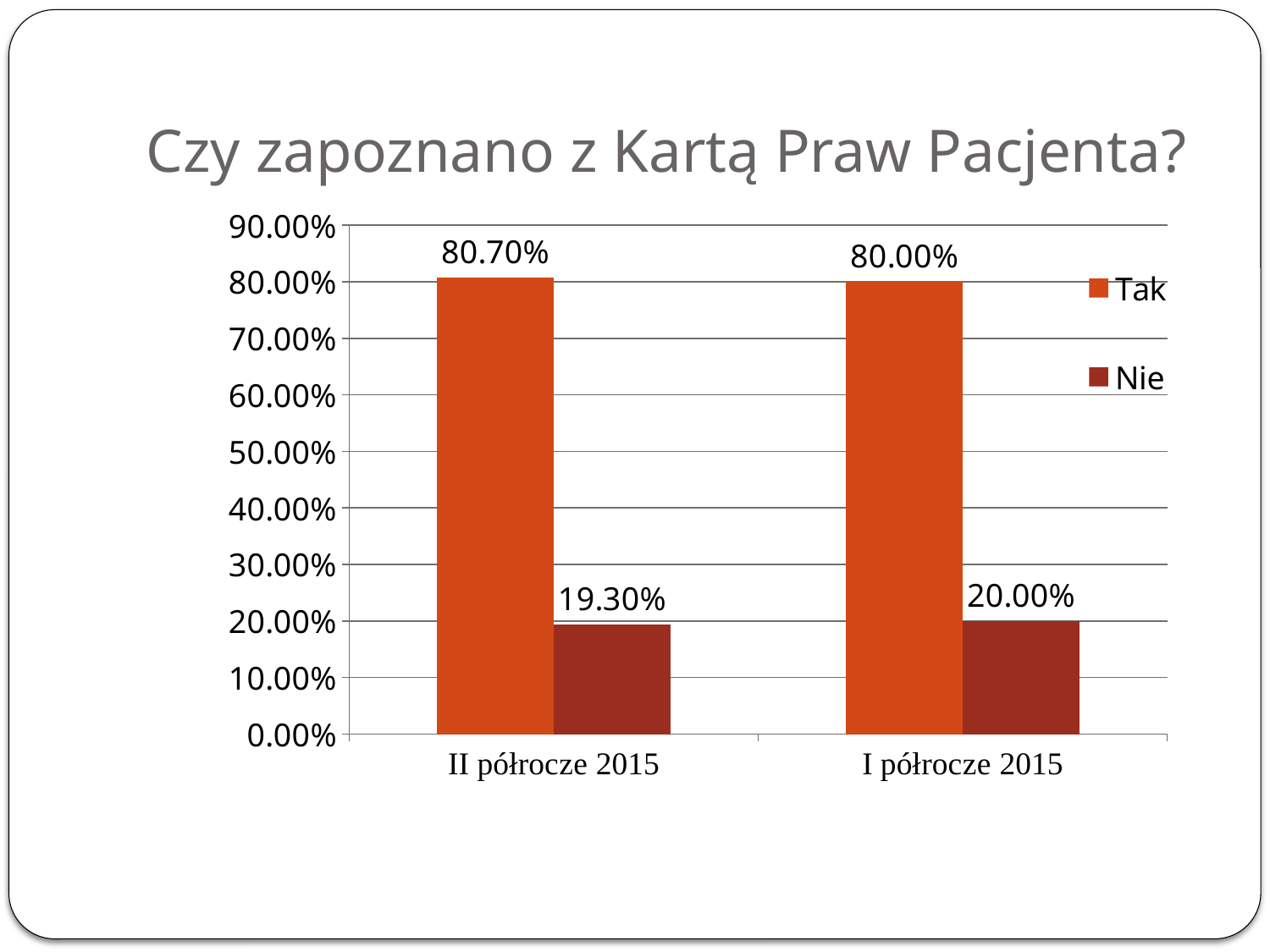
What is the difference between the Tak and Nie values in II półrocze 2015? 61.40% What kind of chart is shown on the slide? Bar chart What is the value for Nie in II półrocze 2015? 19.30% Which category has the lowest Nie value? II półrocze 2015 Which category has the highest Tak value? II półrocze 2015 What is the value for Tak in I półrocze 2015? 80.00% What is the value for Nie in I półrocze 2015? 20.00% What is the value for Tak in II półrocze 2015? 80.70% How many categories are shown on the x axis? 2 What is the title of the chart? Czy zapoznano z Kartą Praw Pacjenta? Which is larger in I półrocze 2015, Tak or Nie? Tak How many series does the legend list? 2